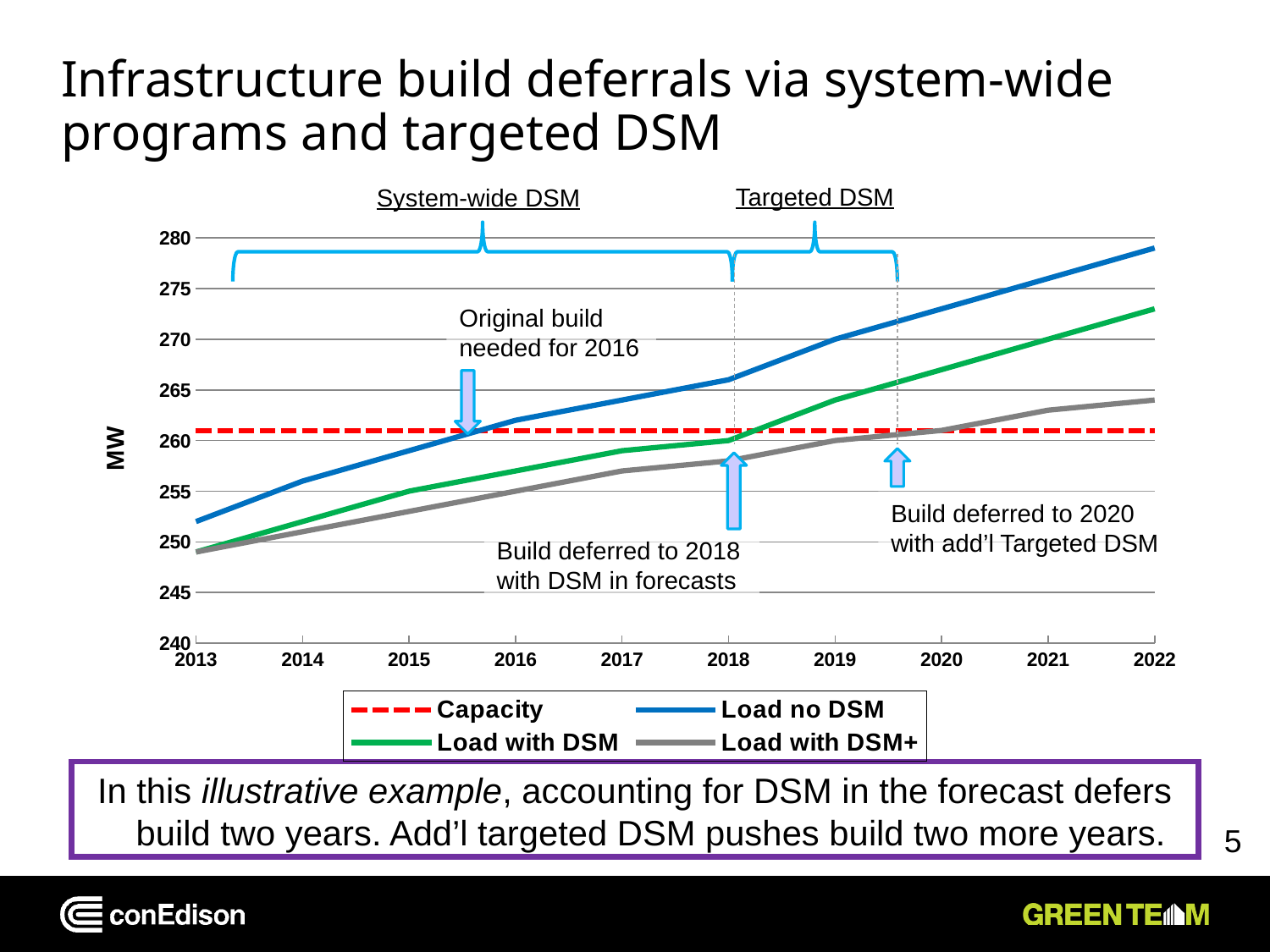
Is the value for Load no DSM in 2022 greater or less than 275? greater How many series does the legend list? 4 Is the value for Load no DSM in 2013 greater or less than 255? less Which series has the highest value in 2022? Load no DSM In 2022, which is larger: Load no DSM or Load with DSM? Load no DSM How many years are shown along the x axis? 10 What is the label on the y axis? MW What kind of chart is shown on the slide? line chart Does the Load no DSM series rise or fall from 2013 to 2022? rise Is the value for Load with DSM+ in 2022 greater or less than 270? less Which of the three load series has the lowest value in 2022? Load with DSM+ Which series is drawn as a red dashed line? Capacity